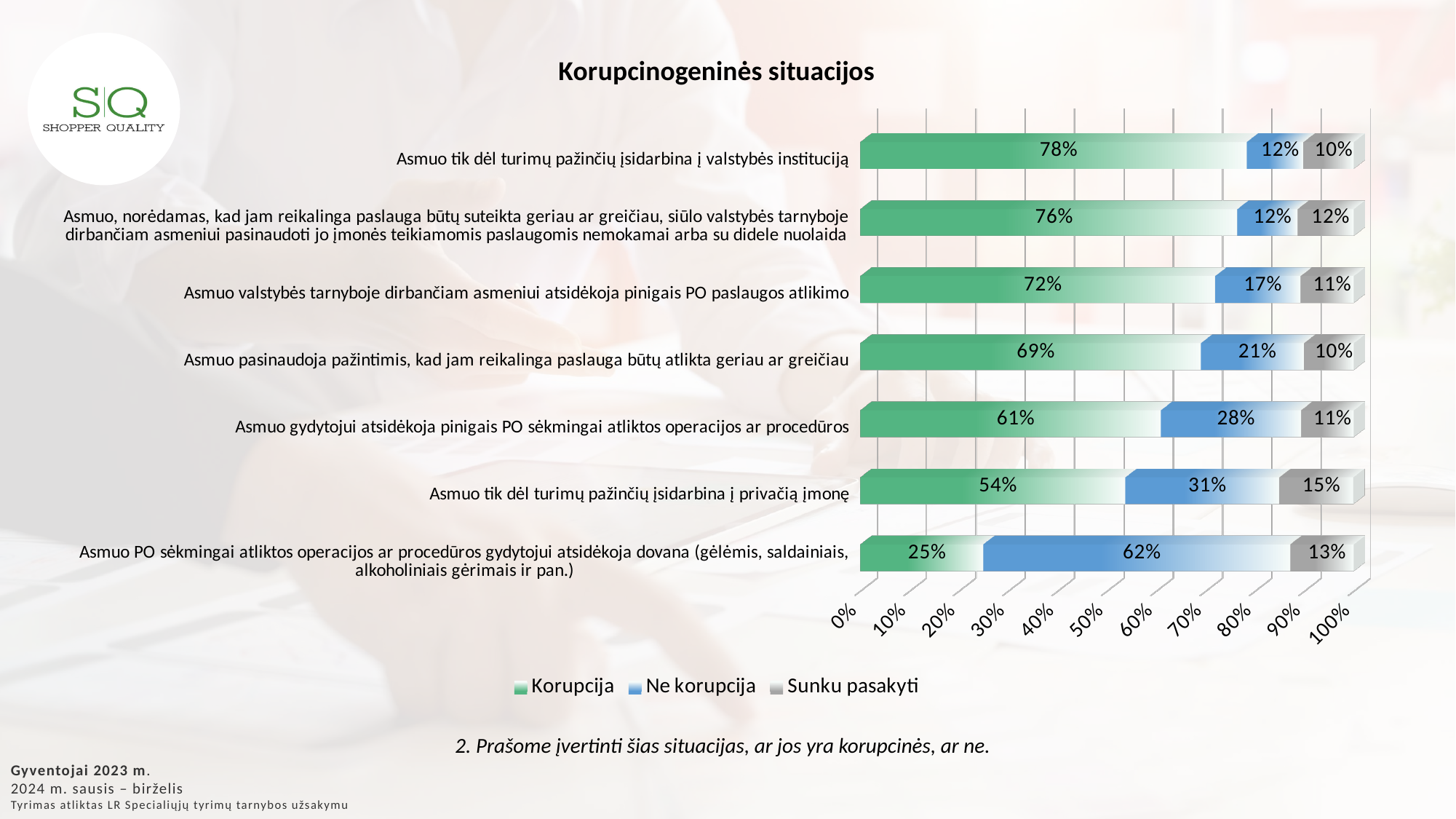
What is the 'Korupcija' value for 'Asmuo tik dėl turimų pažinčių įsidarbina į valstybės instituciją'? 78% What is the total of the stacked bar for 'Asmuo valstybės tarnyboje dirbančiam asmeniui atsidėkoja pinigais PO paslaugos atlikimo'? 100% What is the title of the chart? Korupcinogeninės situacijos What is the difference between the 'Korupcija' and 'Ne korupcija' values for 'Asmuo tik dėl turimų pažinčių įsidarbina į privačią įmonę'? 23% What is the 'Ne korupcija' value for 'Asmuo gydytojui atsidėkoja pinigais PO sėkmingai atliktos operacijos ar procedūros'? 28% What type of chart is shown on the slide? Stacked bar chart How many situations (categories) are plotted in the chart? 7 Which situation has the highest 'Korupcija' share? Asmuo tik dėl turimų pažinčių įsidarbina į valstybės instituciją How many series does the legend list? 3 What is the 'Sunku pasakyti' value for 'Asmuo tik dėl turimų pažinčių įsidarbina į privačią įmonę'? 15% Which is larger for 'Asmuo pasinaudoja pažintimis, kad jam reikalinga paslauga būtų atlikta geriau ar greičiau': the 'Ne korupcija' value or the 'Sunku pasakyti' value? Ne korupcija Which situation has the lowest 'Korupcija' share? Asmuo PO sėkmingai atliktos operacijos ar procedūros gydytojui atsidėkoja dovana (gėlėmis, saldainiais, alkoholiniais gėrimais ir pan.)